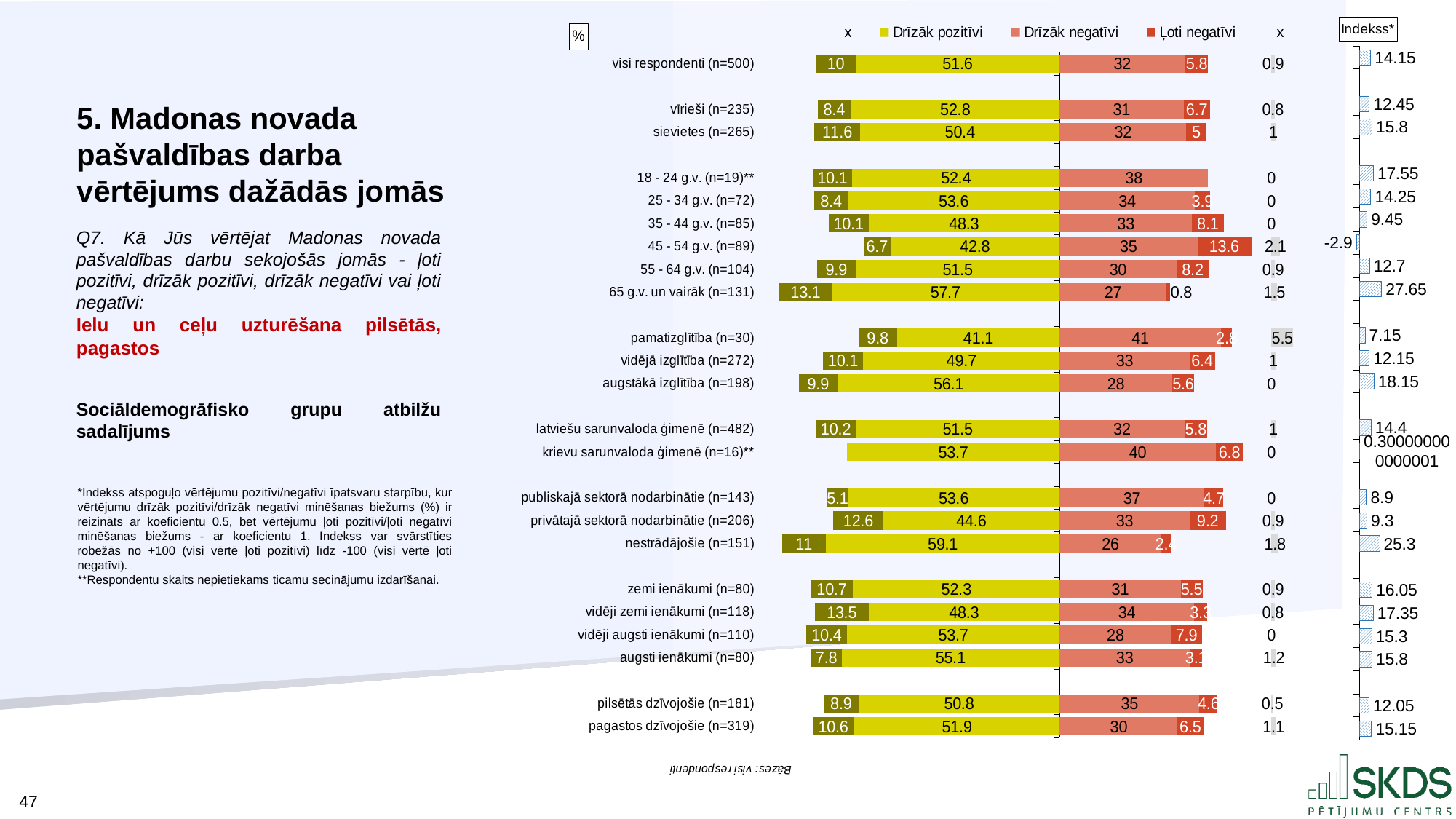
What is the difference between the 'Drīzāk pozitīvi' values for 'vīrieši (n=235)' and 'sievietes (n=265)'? 2.4 What is the 'Drīzāk negatīvi' value for '18 - 24 g.v. (n=19)**'? 38 Which group has the highest value in the 'Indekss*' column? 65 g.v. un vairāk (n=131) Which group has the highest 'Drīzāk pozitīvi' value? nestrādājošie (n=151) Which has a larger 'Drīzāk negatīvi' value: 'pilsētās dzīvojošie (n=181)' or 'pagastos dzīvojošie (n=319)'? pilsētās dzīvojošie (n=181) What is the 'Ļoti negatīvi' value for '45 - 54 g.v. (n=89)'? 13.6 Which group has the lowest value in the 'Indekss*' column? 45 - 54 g.v. (n=89) Which group has the highest 'Drīzāk negatīvi' value? pamatizglītība (n=30) In the 'Indekss*' column, what is the index value for '65 g.v. un vairāk (n=131)'? 27.65 What is the difference between the 'Indekss*' values for 'augstākā izglītība (n=198)' and 'pamatizglītība (n=30)'? 11 What is the 'Drīzāk pozitīvi' value for 'visi respondenti (n=500)'? 51.6 What kind of chart is used to show the evaluation by socio-demographic groups? bar chart